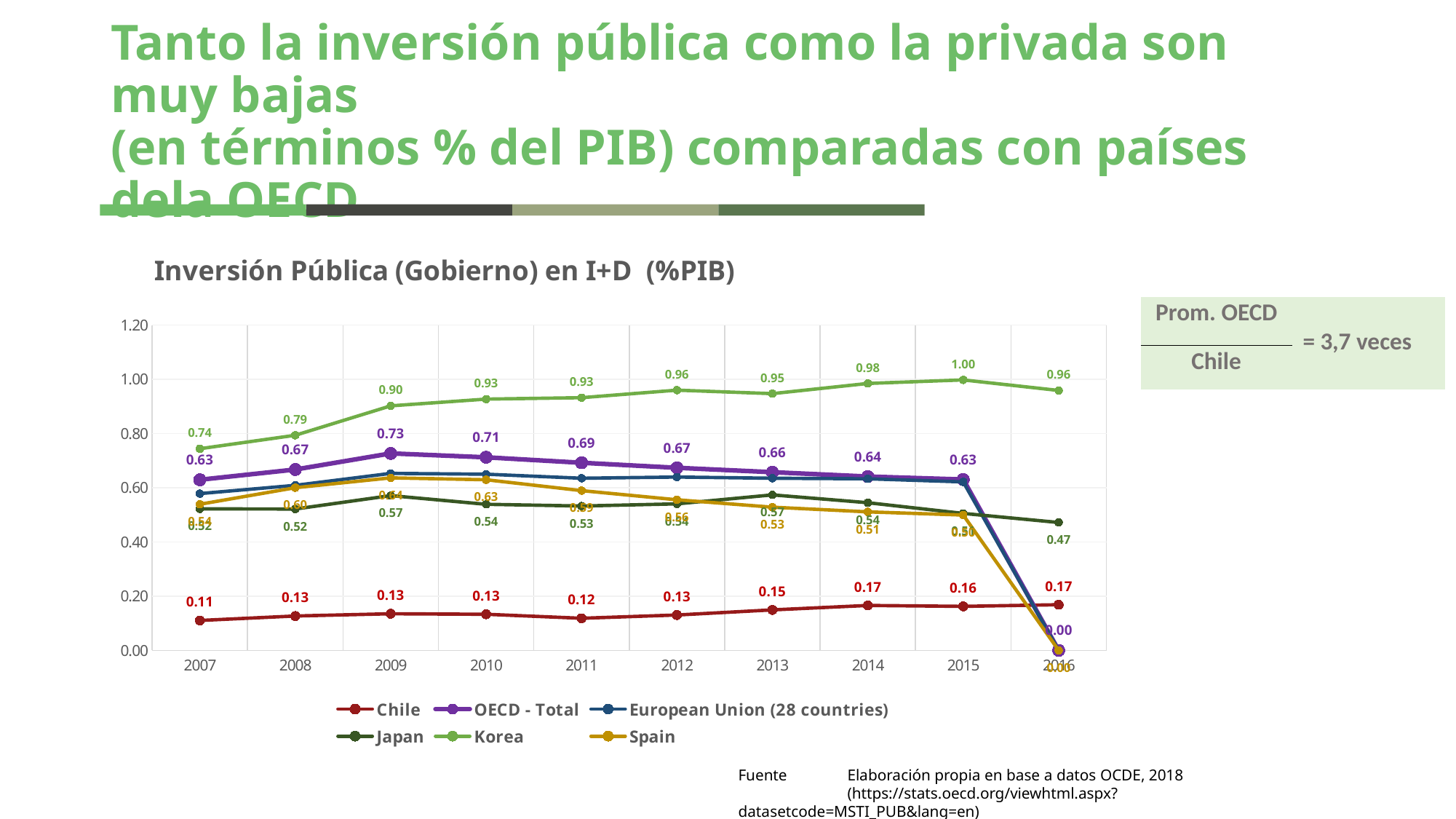
What is the title of the chart? Inversión Pública (Gobierno) en I+D (%PIB) What is the value for Chile in 2016? 0.17 In which year does Korea reach its highest value? 2015 Is the value for Japan in 2014 greater or less than 0.60? less What is the difference between the Korea and Chile values in 2015? 0.84 In which year is the value for Chile lowest? 2007 In 2012, which is larger: the value for Korea or the value for OECD - Total? Korea What is the value for OECD - Total in 2009? 0.73 What is the value for Korea in 2015? 1.00 What kind of chart is shown on the slide? line chart How many years are shown on the x axis? 10 How many series does the legend list? 6